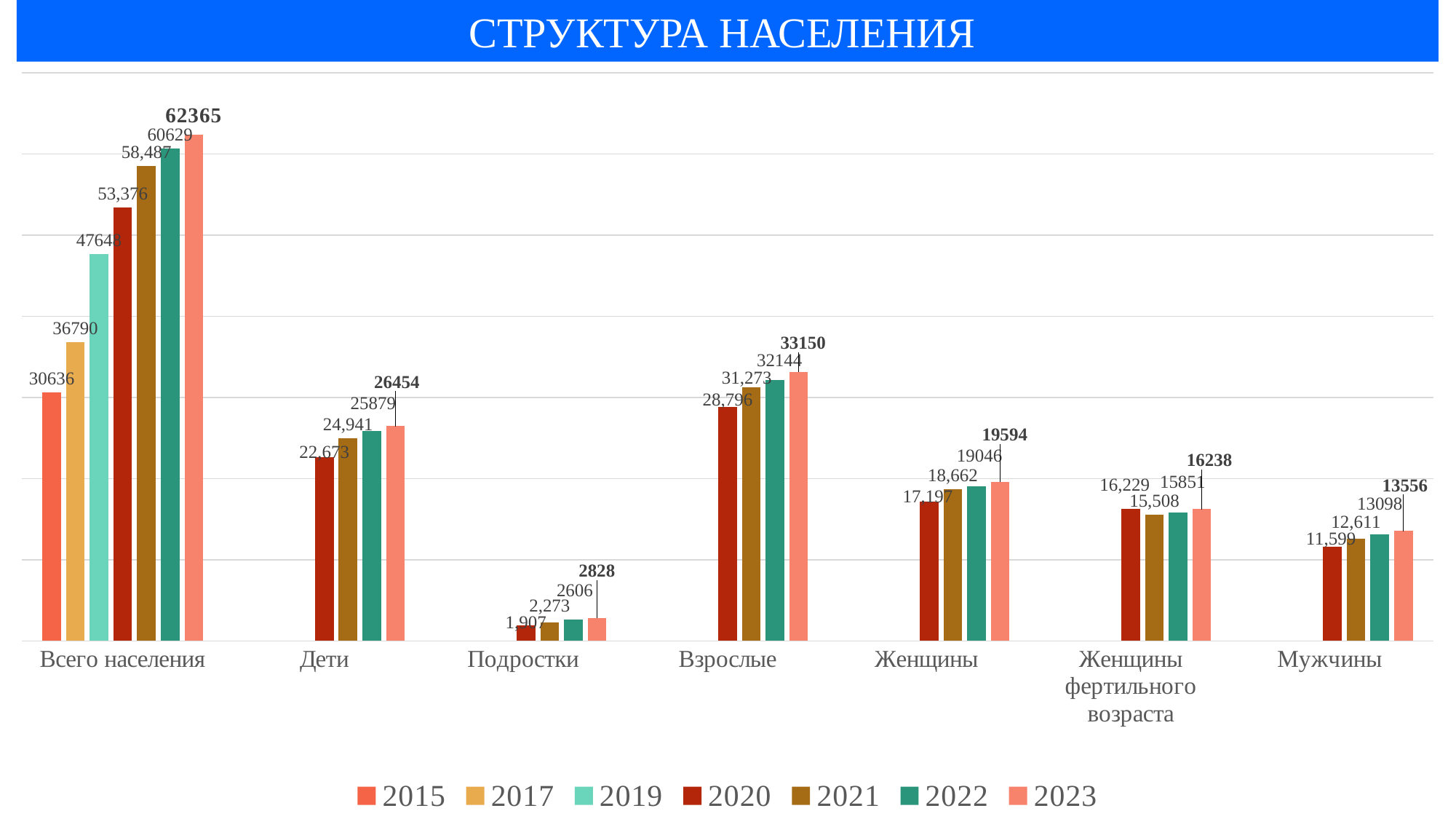
Which category has the highest value in 2023? Всего населения Which is larger for Дети: the 2021 value or the 2023 value? 2023 What is the value for Всего населения in 2023? 62365 What is the value for Женщины фертильного возраста in 2021? 15,508 Does the value for Всего населения rise or fall from 2015 to 2023? rise What is the value for Мужчины in 2022? 13098 What is the difference between the 2023 and 2015 values for Всего населения? 31729 How many series does the legend list? 7 Which category has the lowest value in 2020? Подростки How many categories are shown on the x axis? 7 What is the value for Подростки in 2020? 1,907 What is the difference between the 2023 and 2020 values for Взрослые? 4354